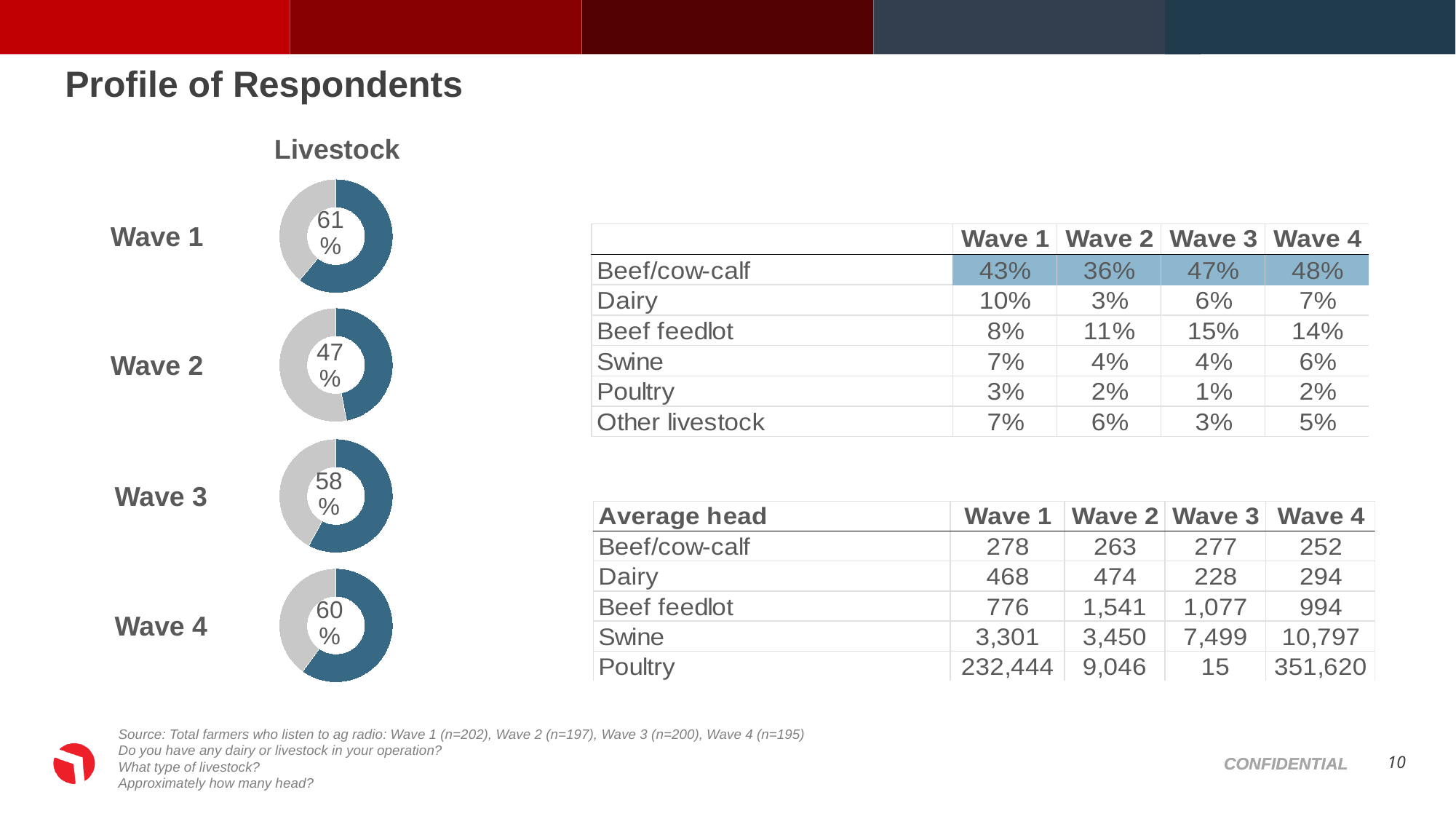
In the Livestock donut charts, what is the difference between the Wave 1 and Wave 2 percentages? 14% What type of chart is used to show the Livestock percentages for each wave? Donut chart In the Livestock donut charts, what percentage is shown for Wave 1? 61% In the Livestock donut charts, which is larger, the Wave 3 percentage or the Wave 2 percentage? Wave 3 In the Livestock donut charts, what percentage is shown for Wave 3? 58% In the Livestock donut charts, what percentage is shown for Wave 2? 47% What is the title above the donut charts on the left of the slide? Livestock Among the Livestock donut charts, which wave has the highest percentage? Wave 1 In the Livestock donut charts, what percentage is shown for Wave 4? 60% How many donut charts are shown under the Livestock heading? 4 In the Livestock donut charts, what is the difference between the Wave 4 and Wave 3 percentages? 2% Among the Livestock donut charts, which wave has the lowest percentage? Wave 2